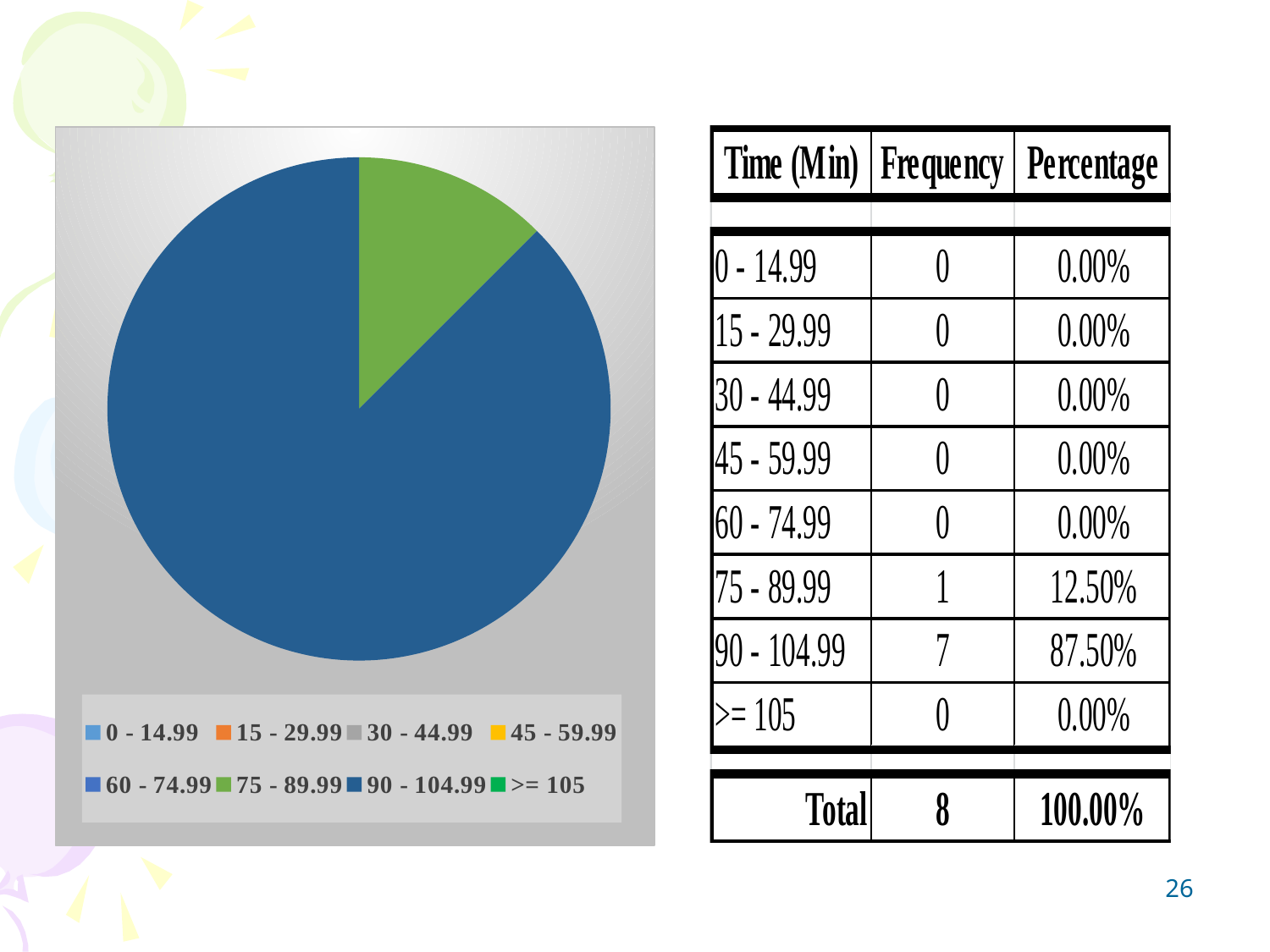
According to the table, what is the frequency for the 90 - 104.99 time bin? 7 What colour is the slice for the 75 - 89.99 category in the pie chart? green How many categories does the pie chart's legend list? 8 Which category has the largest slice in the pie chart? 90 - 104.99 According to the table, what is the frequency for the 75 - 89.99 time bin? 1 What is the difference in frequency between the 90 - 104.99 bin and the 75 - 89.99 bin? 6 According to the table, what percentage does the 75 - 89.99 time bin account for? 12.50% According to the table, what percentage does the 90 - 104.99 time bin account for? 87.50% What is the total frequency shown in the table? 8 Which of the two visible slices in the pie chart is larger, 75 - 89.99 or 90 - 104.99? 90 - 104.99 What kind of chart is shown on the left of the slide? pie chart What is the label of the last entry in the pie chart's legend? >= 105